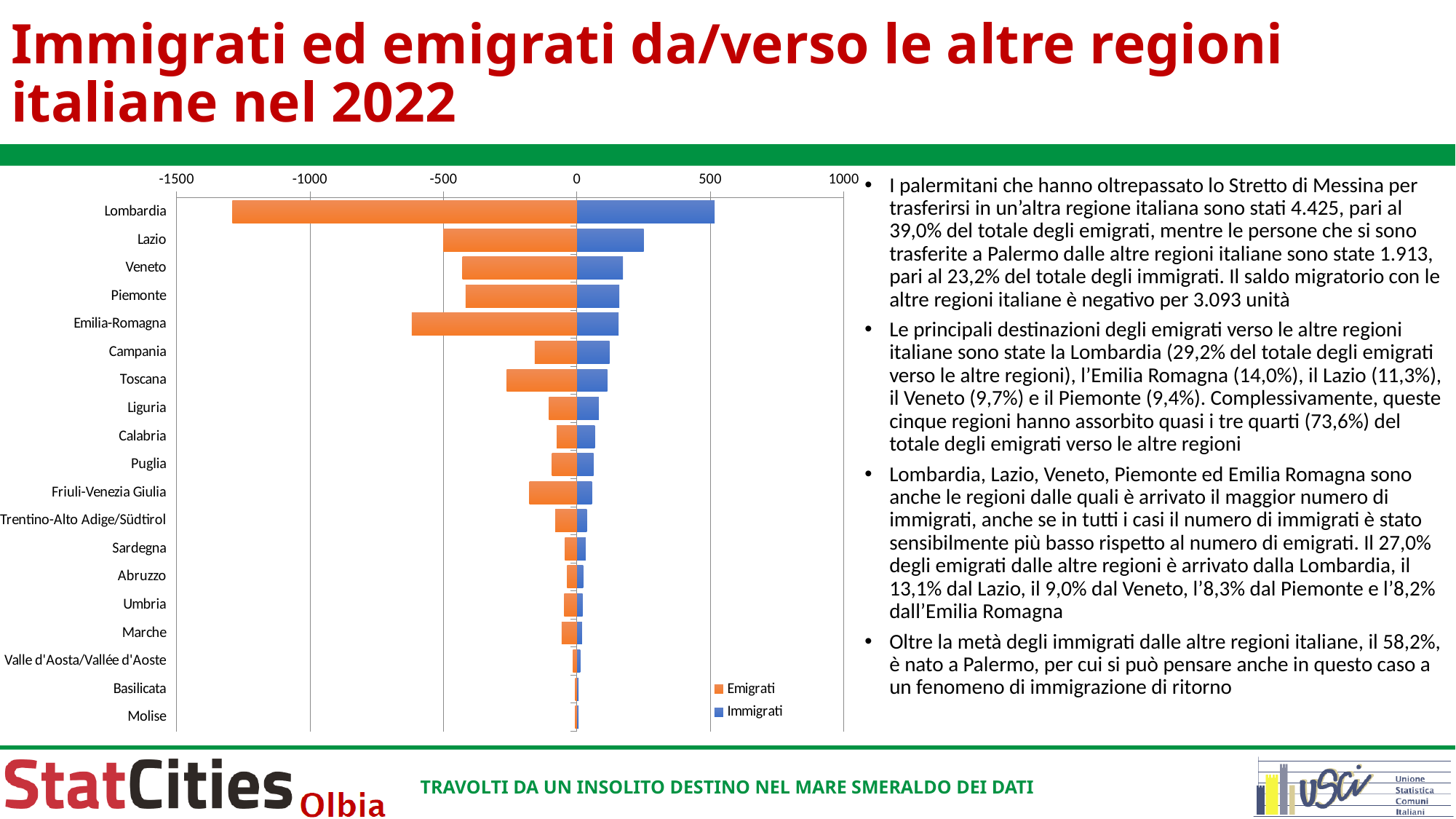
How many series does the chart legend list? 2 Is the Emigrati value for Emilia-Romagna greater or less than -500? less Which region has the largest Emigrati bar? Lombardia What kind of chart is shown on the slide? bar chart Which region has the larger Emigrati bar, Emilia-Romagna or Veneto? Emilia-Romagna Is the Emigrati value for Lombardia greater or less than -1000? less How many regions are plotted on the chart? 19 Is the Immigrati value for Lazio greater or less than 500? less Which colour represents the Emigrati series in the chart? orange Which region has the largest Immigrati bar? Lombardia Which region has the larger Immigrati bar, Lazio or Veneto? Lazio